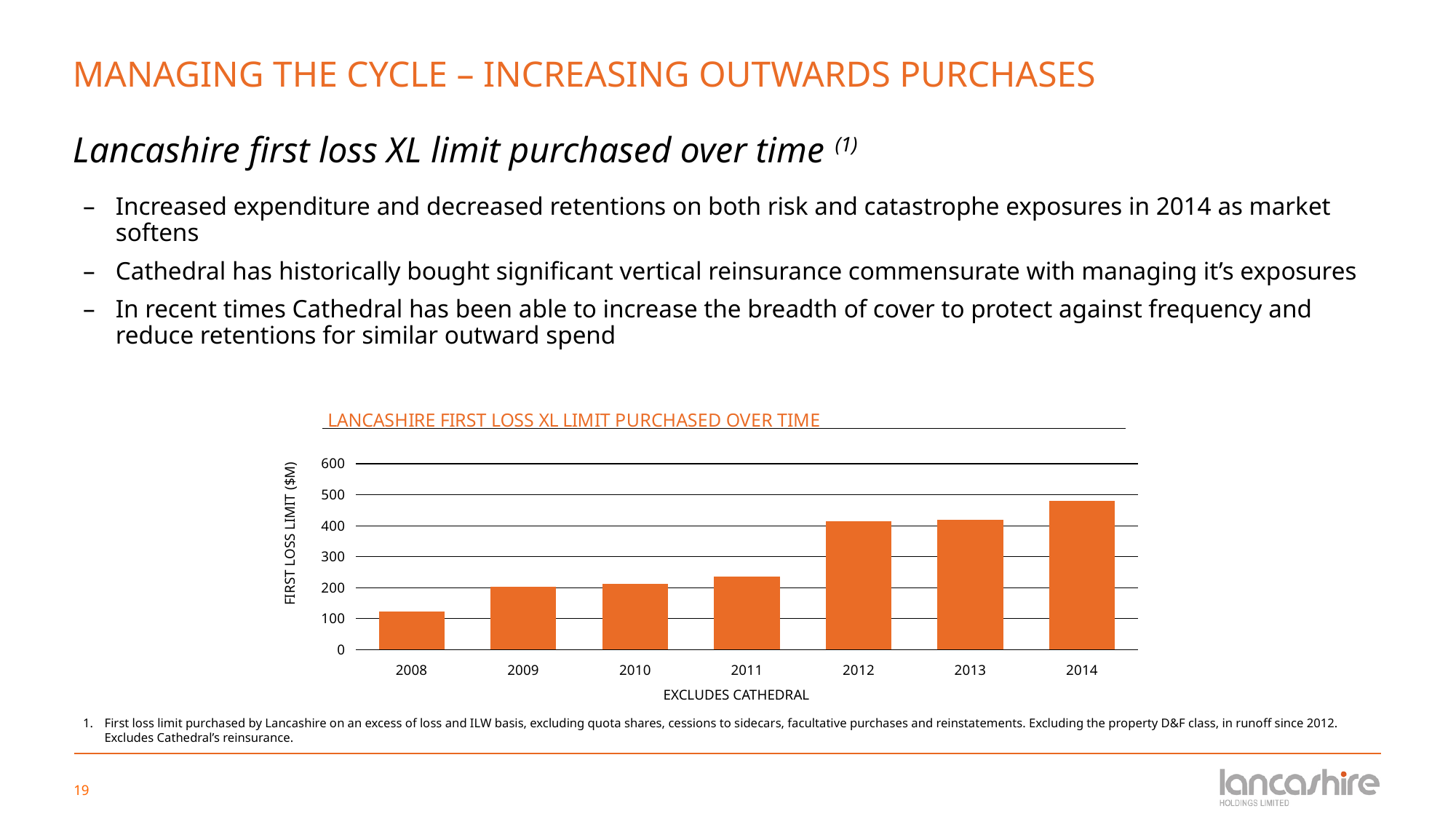
Is the value for 2008 greater or less than 200? less Which is larger, the value for 2011 or the value for 2012? 2012 Which year has the highest first loss XL limit purchased? 2014 Is the value for 2012 greater or less than 300? greater Do the values generally rise or fall from 2008 to 2014? Rise What note appears below the x axis of the chart? EXCLUDES CATHEDRAL Is the value for 2011 greater or less than 300? less How many years are shown on the x axis of the chart? 7 What kind of chart is shown on the slide? Bar chart Which year has the lowest first loss XL limit purchased? 2008 What is the label on the vertical axis of the chart? FIRST LOSS LIMIT ($M)